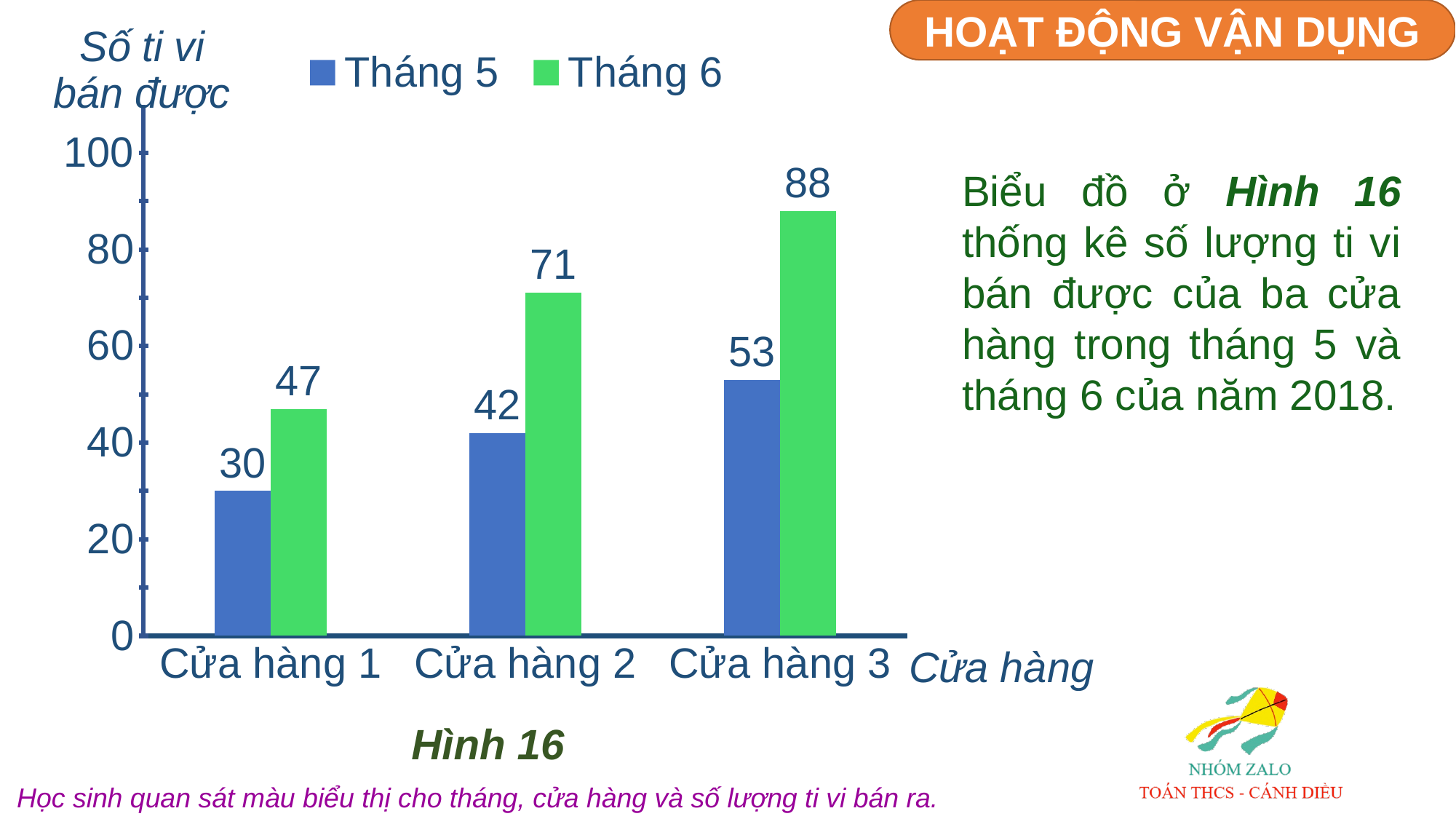
Which is larger: the Tháng 5 value for Cửa hàng 2 or the Tháng 6 value for Cửa hàng 1? Tháng 6 value for Cửa hàng 1 What is the difference between the Tháng 6 and Tháng 5 values for Cửa hàng 3? 35 What kind of chart is shown on the slide? Bar chart How many stores (categories) are shown on the x axis? 3 Which colour represents Tháng 6 in the legend? Green What is the value for Cửa hàng 3 in Tháng 5? 53 What is the difference between the Tháng 6 values for Cửa hàng 2 and Cửa hàng 1? 24 How many TVs did Cửa hàng 1 sell in Tháng 5? 30 How many TVs did Cửa hàng 2 sell in Tháng 6? 71 How many series does the legend list? 2 Which store has the highest value in Tháng 6? Cửa hàng 3 Which store has the lowest value in Tháng 5? Cửa hàng 1